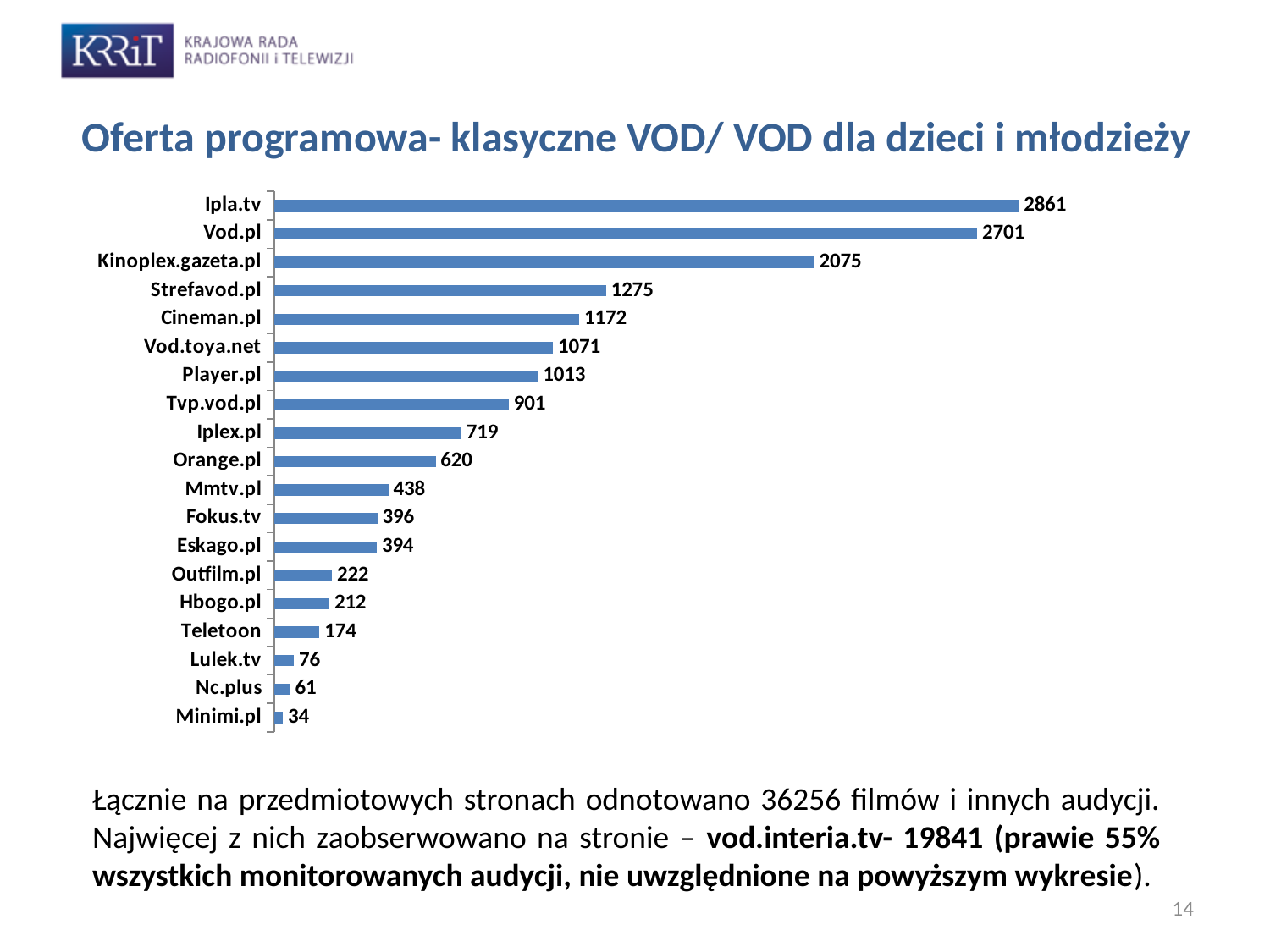
What colour are the bars in the chart? Blue What is the value for Teletoon? 174 What is the difference between the values for Kinoplex.gazeta.pl and Strefavod.pl? 800 What is the value for Ipla.tv? 2861 What kind of chart is shown on the slide? Bar chart Which is larger, the value for Player.pl or the value for Tvp.vod.pl? Player.pl What is the value for Strefavod.pl? 1275 What is the difference between the values for Ipla.tv and Vod.pl? 160 Which category has the lowest value? Minimi.pl Which category has the highest value? Ipla.tv Which is larger, the value for Orange.pl or the value for Iplex.pl? Iplex.pl How many categories are shown in the chart? 19